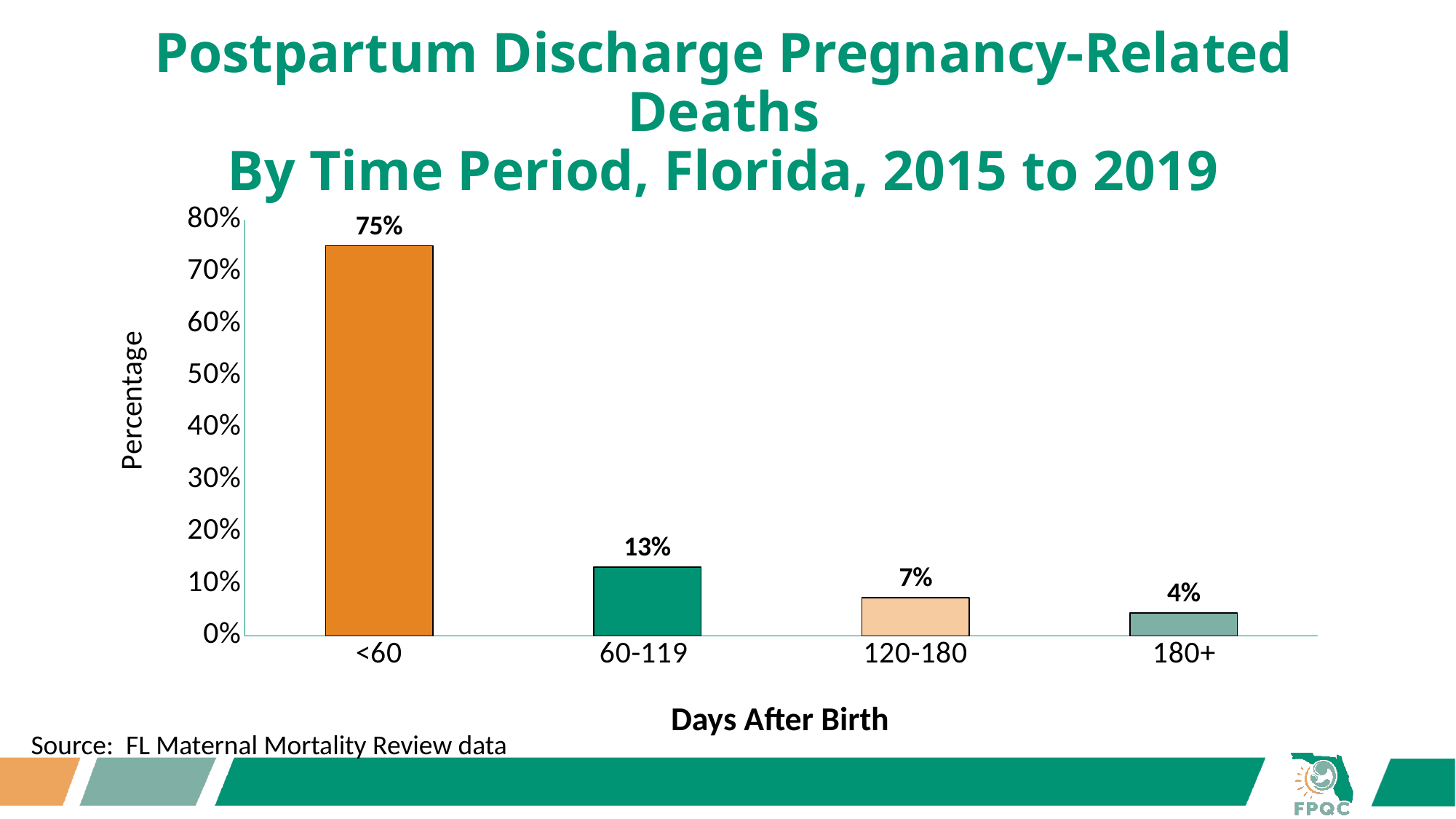
Do the values rise or fall moving from <60 to 180+ along the x axis? Fall What kind of chart is shown on the slide? Bar chart How many time period categories are shown on the x axis? 4 Is the value for 60-119 greater or less than 10%? greater Which time period has the lowest percentage of deaths? 180+ What is the value for the 180+ days after birth category? 4% Which time period has the highest percentage of deaths? <60 What is the difference between the <60 and 60-119 categories? 62 percentage points What percentage of postpartum discharge pregnancy-related deaths occurred at <60 days after birth? 75% What percentage is shown for the 120-180 days after birth category? 7% What is the value for the 60-119 days after birth category? 13% Which is larger, the value for 120-180 or the value for 180+? 120-180